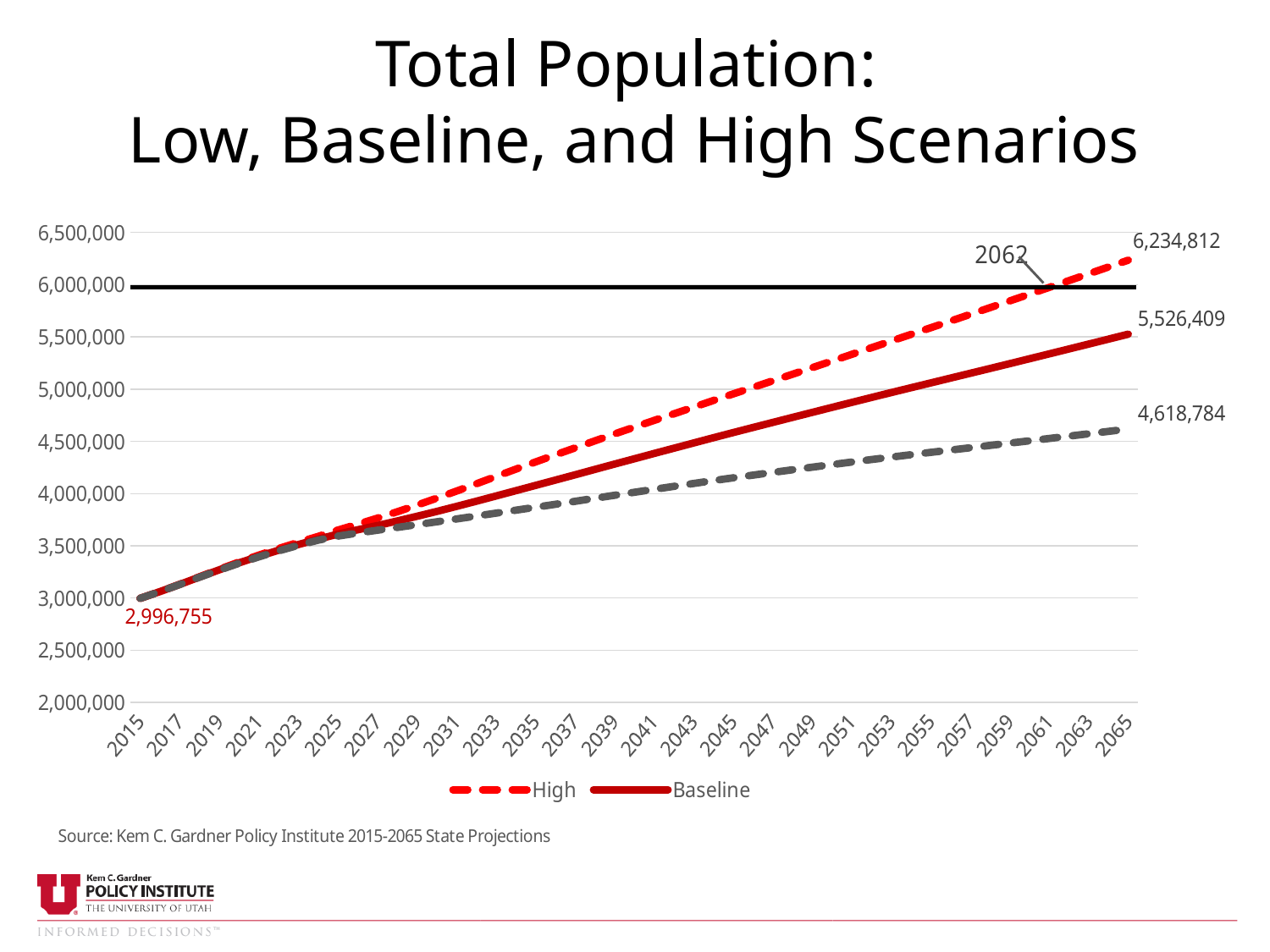
Do the plotted lines rise or fall from 2015 to 2065? rise What is the value labeled at the end of the lowest line in 2065? 4,618,784 What is the difference between the High and Baseline values in 2065? 708,403 What is the labeled starting population value in 2015? 2,996,755 How much higher is the High scenario value in 2065 than the 2015 starting value of 2,996,755? 3,238,057 What kind of chart is shown on the slide? line chart What is the value of the Baseline scenario in 2065? 5,526,409 How many series does the legend list? 2 Which scenario has the larger value in 2065, High or Baseline? High What is the value of the High scenario in 2065? 6,234,812 In which year does the annotation show the High scenario crossing the 6,000,000 line? 2062 Is the value of the High scenario in 2035 greater or less than 4,000,000? greater